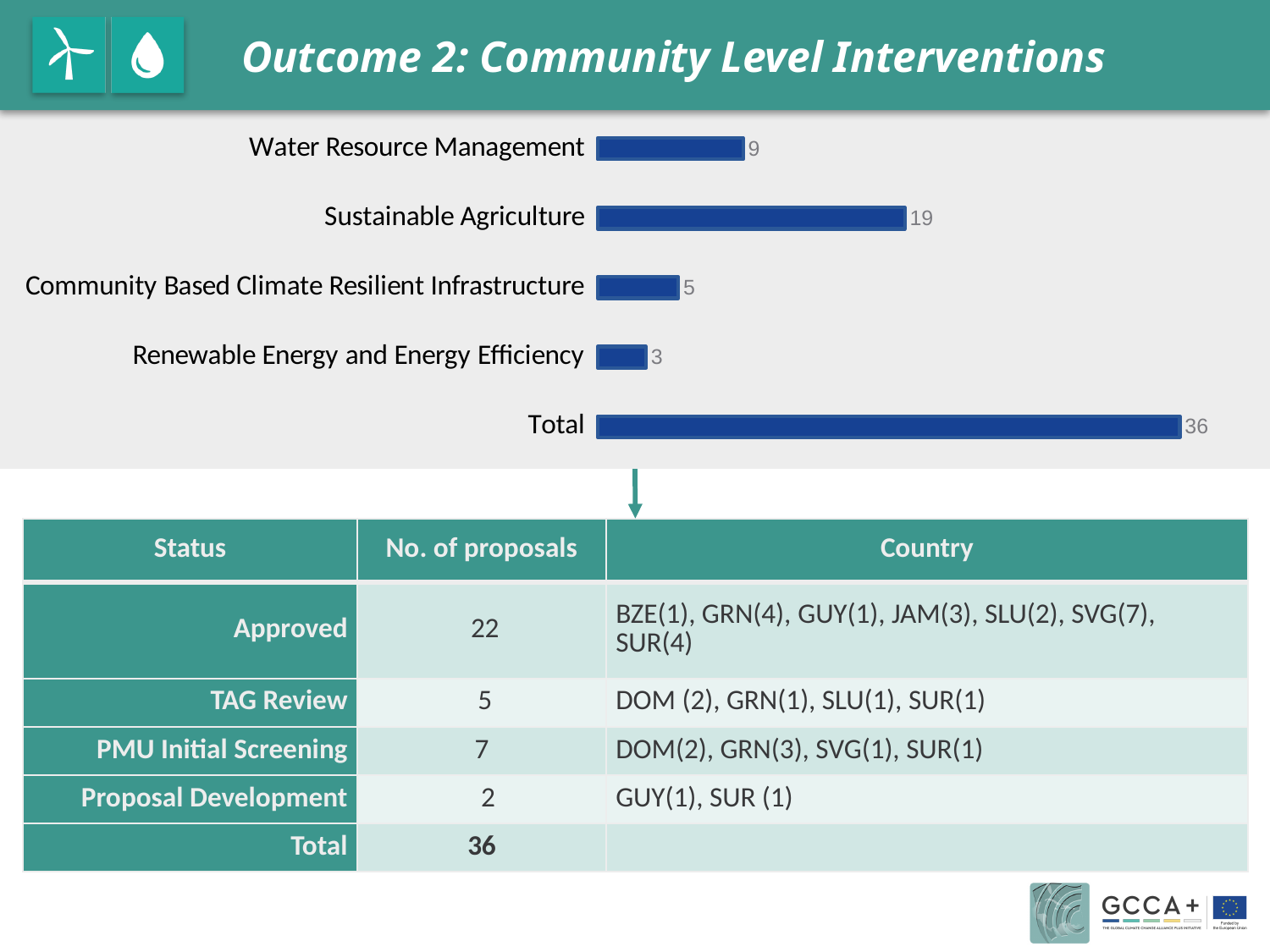
What is the title of the slide containing the chart? Outcome 2: Community Level Interventions Which category has the lowest value? Renewable Energy and Energy Efficiency What kind of chart is shown on the slide? Bar chart What is the value shown for the Total bar? 36 Which is larger, the value for Water Resource Management or the value for Community Based Climate Resilient Infrastructure? Water Resource Management What is the value for Community Based Climate Resilient Infrastructure? 5 What is the value for Renewable Energy and Energy Efficiency? 3 What is the value for Water Resource Management? 9 What is the value for Sustainable Agriculture? 19 Excluding the Total bar, which category has the highest value? Sustainable Agriculture What is the difference between the values for Sustainable Agriculture and Water Resource Management? 10 How many bars are shown in the chart, including the Total bar? 5